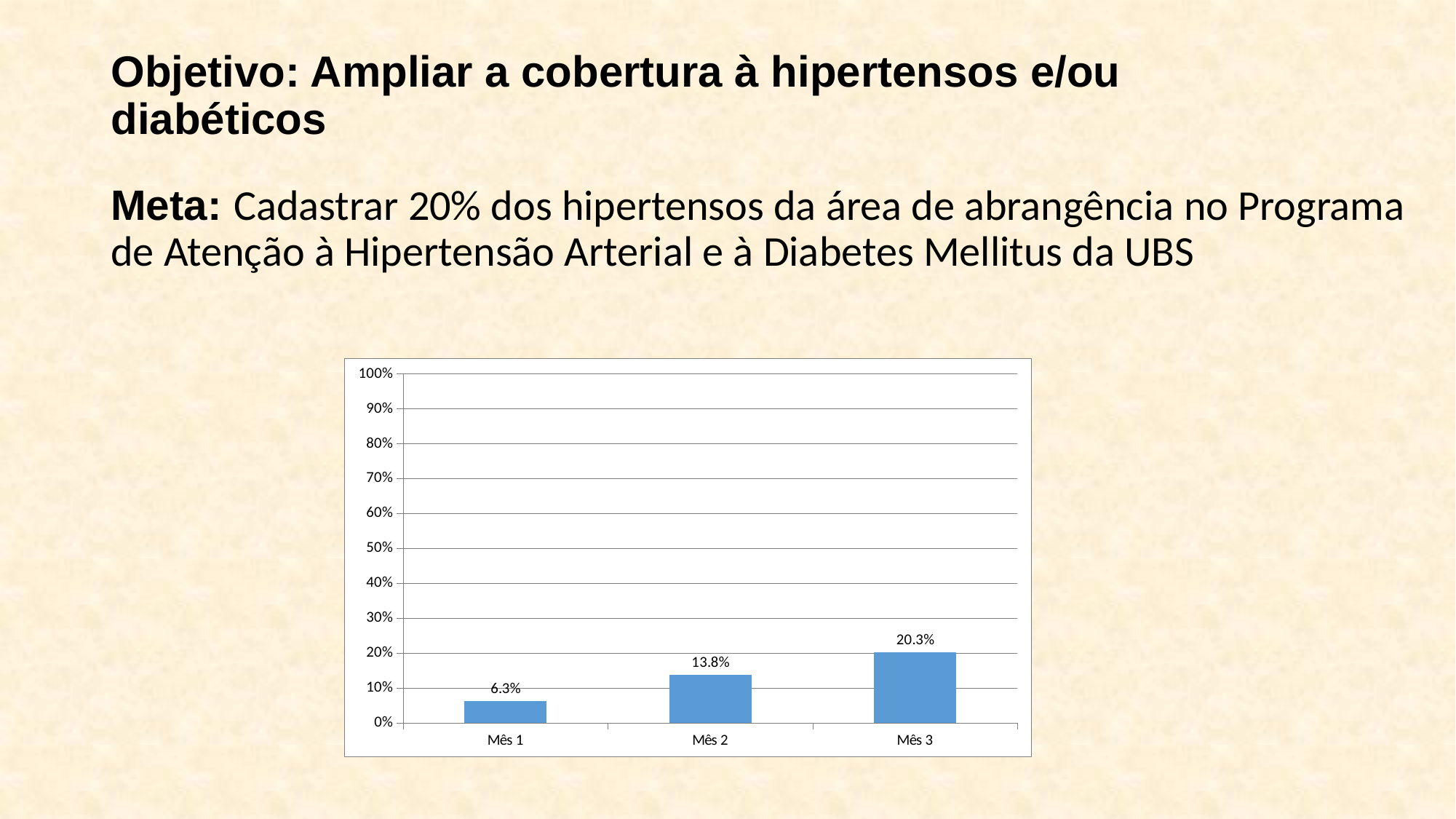
Is the value for Mês 3 greater or less than 10%? greater What kind of chart is shown on the slide? bar chart Do the values rise or fall from Mês 1 to Mês 3? rise Which month has the highest value? Mês 3 How many months are shown on the x axis? 3 What is the value for Mês 1? 6.3% What is the value for Mês 3? 20.3% What is the value for Mês 2? 13.8% Which is larger, the value for Mês 2 or the value for Mês 3? Mês 3 What is the difference between the values for Mês 3 and Mês 1? 14% What is the difference between the values for Mês 2 and Mês 1? 7.5% Which month has the lowest value? Mês 1